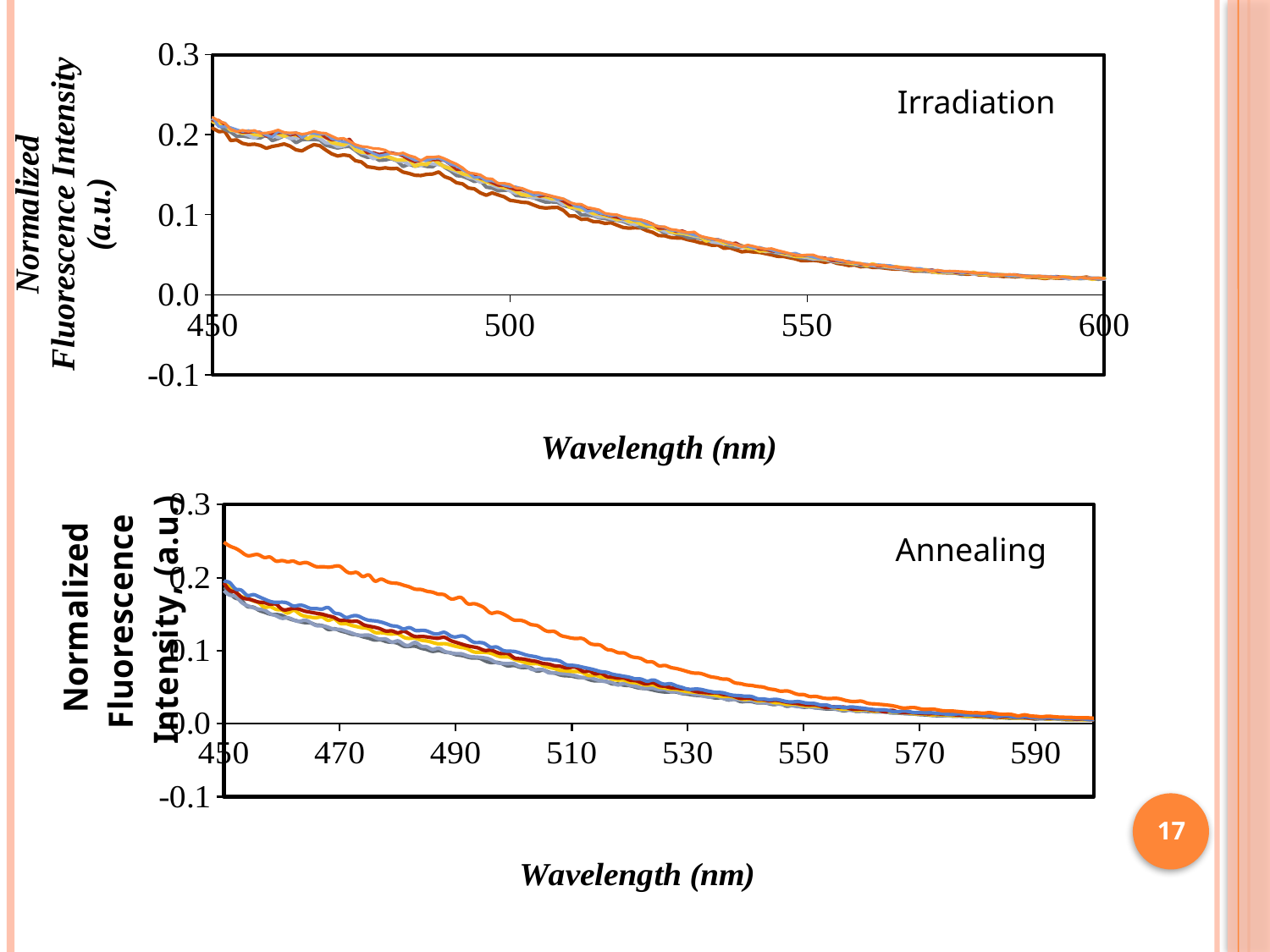
What is the highest value shown on the y-axis of the Annealing chart? 0.3 In the Irradiation chart, are the values at 500 nm greater or less than 0.1? greater In the Annealing chart, is the value of the topmost (orange) line at 490 nm greater or less than 0.1? greater What kind of chart is the Irradiation chart at the top of the slide? line chart In the Annealing chart, do the plotted values rise or fall as wavelength increases from 450 to 590 nm? fall What is the x-axis label of the Irradiation chart? Wavelength (nm) In the Irradiation chart, do the plotted values rise or fall as wavelength increases from 450 to 600 nm? fall In the Irradiation chart, are the values at 500 nm greater or less than 0.2? less What kind of chart is the Annealing chart at the bottom of the slide? line chart